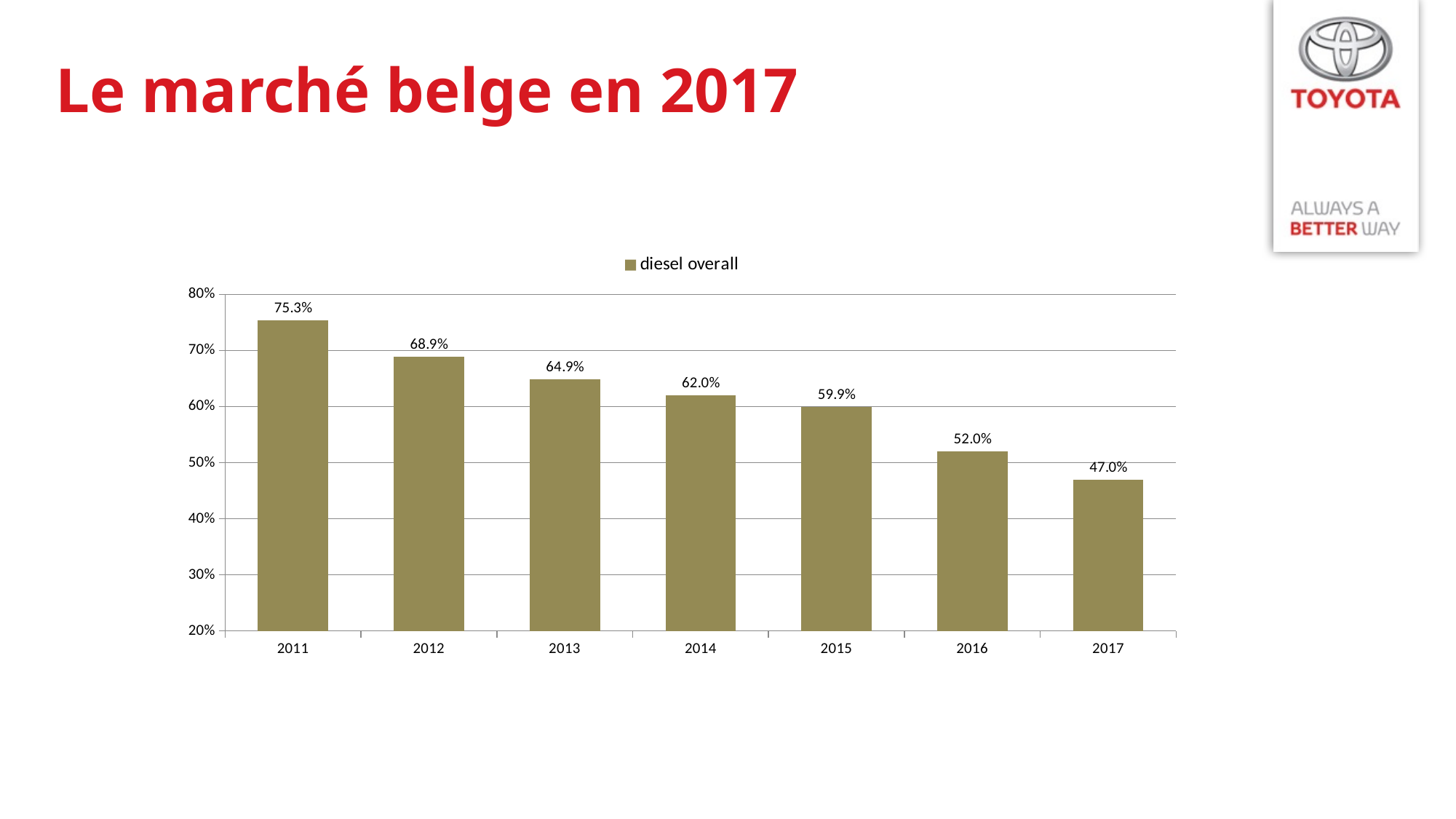
What is the diesel overall share for 2011? 75.3% Which year has the lowest diesel overall share? 2017 Is the diesel overall share for 2012 greater or less than 70%? less Which year has a larger diesel overall share, 2013 or 2016? 2013 What is the difference between the diesel overall share in 2011 and in 2017? 28.3% How many years are shown on the x axis of the chart? 7 What is the difference between the diesel overall share in 2015 and in 2016? 7.9% Which year has the highest diesel overall share? 2011 Does the diesel overall share rise or fall from 2011 to 2017? fall What is the diesel overall share for 2014? 62.0% What kind of chart is shown on the slide? bar chart What is the diesel overall share for 2017? 47.0%